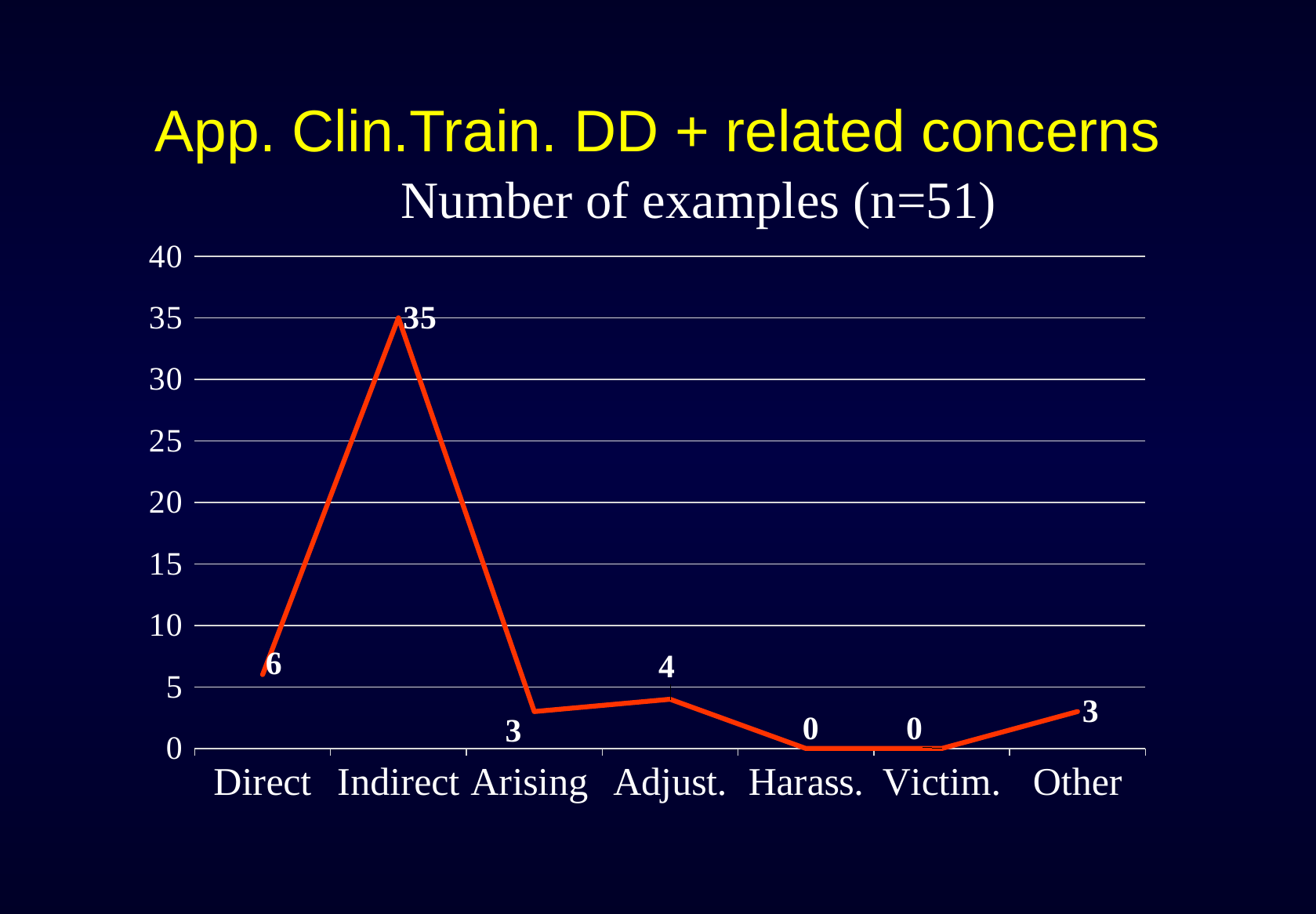
What is the chart's title? Number of examples (n=51) Which category has the highest value? Indirect What is the difference between the values for Indirect and Direct? 29 What kind of chart is shown on the slide? line chart Is the value for Indirect greater or less than 30? greater What is the value for Other? 3 How many categories are shown on the x axis? 7 What is the value for Adjust.? 4 What is the value for Indirect? 35 What is the value for Direct? 6 Which is larger, the value for Direct or the value for Adjust.? Direct Does the value rise or fall from Indirect to Arising? fall